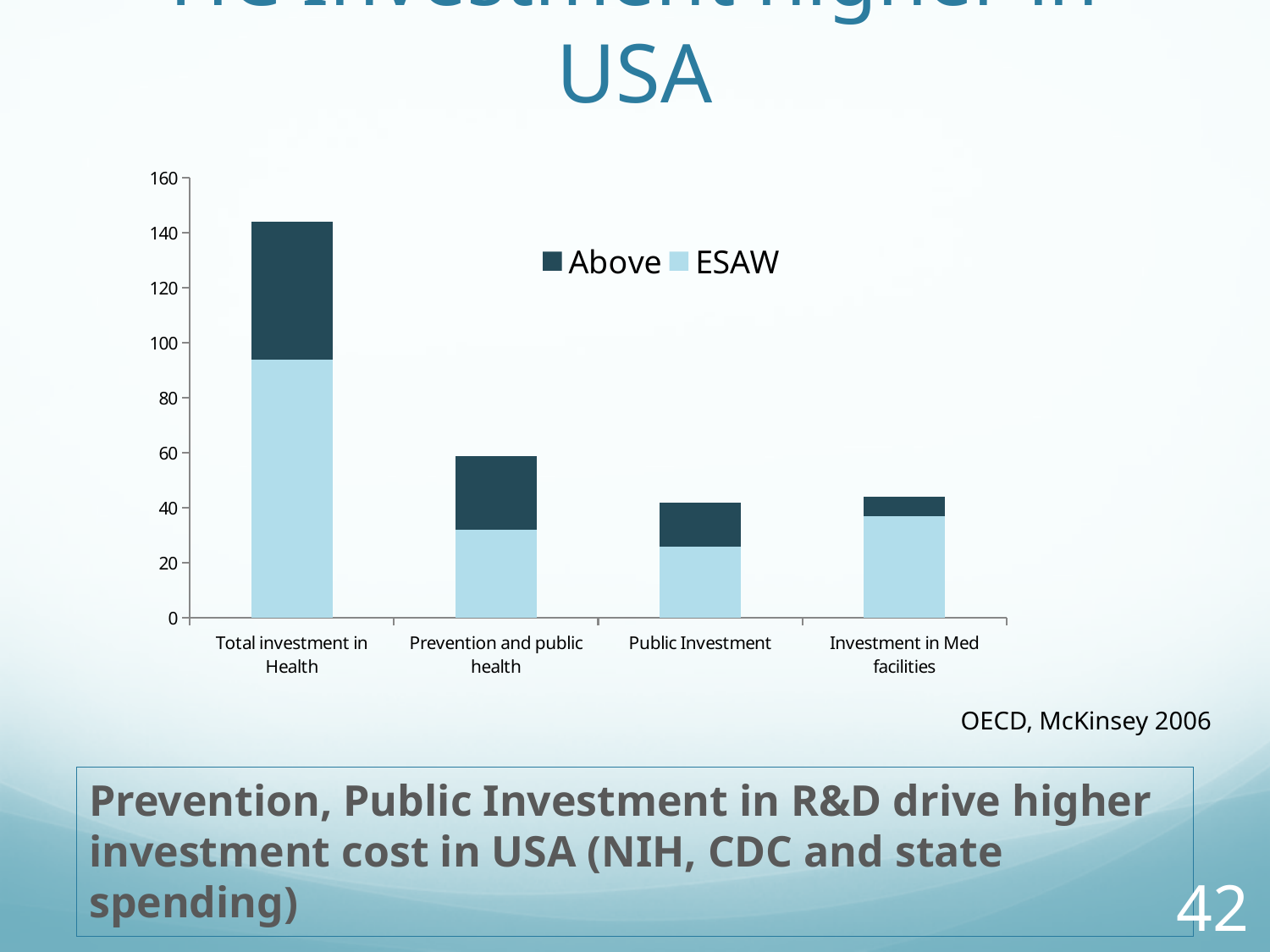
Which category has the tallest stacked bar overall? Total investment in Health Which category has the smallest Above segment? Investment in Med facilities Which has the larger Above segment: Prevention and public health or Public Investment? Prevention and public health What are the two series named in the legend? Above and ESAW What source is cited below the chart? OECD, McKinsey 2006 Is the total stacked value for Total investment in Health greater or less than 120? greater Is the ESAW value for Total investment in Health greater or less than 80? greater Is the ESAW value for Investment in Med facilities greater or less than 20? greater How many categories are shown on the x axis? 4 How many series does the legend list? 2 What kind of chart is shown on the slide? Stacked bar chart